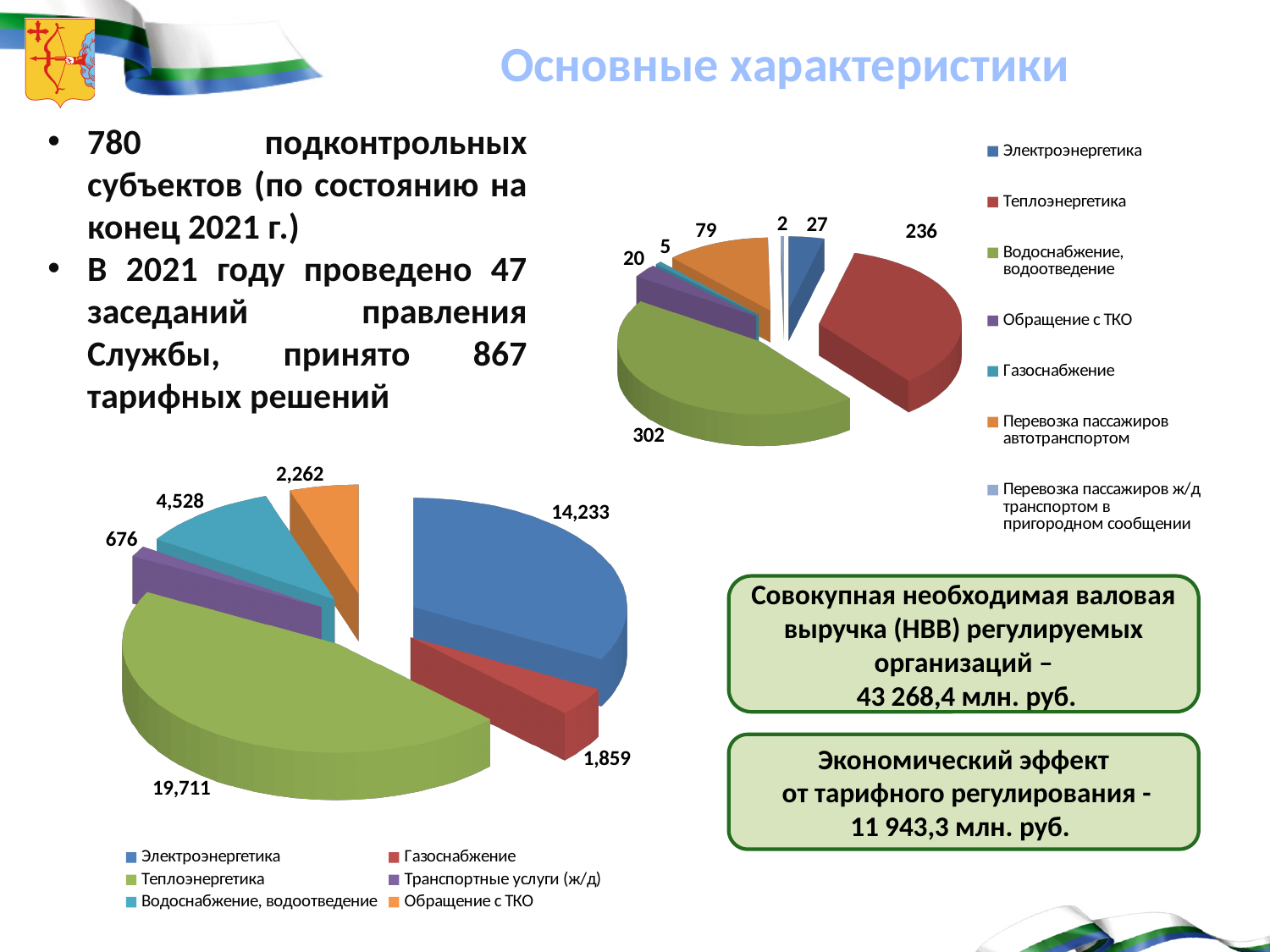
In the bottom-left pie chart, what is the value for Газоснабжение? 1,859 In the top-right pie chart, which category has the largest value? Водоснабжение, водоотведение In the bottom-left pie chart, what is the difference between the values for Теплоэнергетика and Электроэнергетика? 5,478 What type of chart is the bottom-left chart? Pie chart In the bottom-left pie chart, what is the value for Теплоэнергетика? 19,711 In the bottom-left pie chart, which category has the smallest value? Транспортные услуги (ж/д) In the top-right pie chart, what is the difference between the values for Водоснабжение, водоотведение and Теплоэнергетика? 66 In the bottom-left pie chart, which is larger: Электроэнергетика or Водоснабжение, водоотведение? Электроэнергетика How many categories does the legend of the top-right pie chart list? 7 In the top-right pie chart, what is the value for Водоснабжение, водоотведение? 302 In the top-right pie chart, what is the value for Теплоэнергетика? 236 In the top-right pie chart, which category has the smallest value? Перевозка пассажиров ж/д транспортом в пригородном сообщении